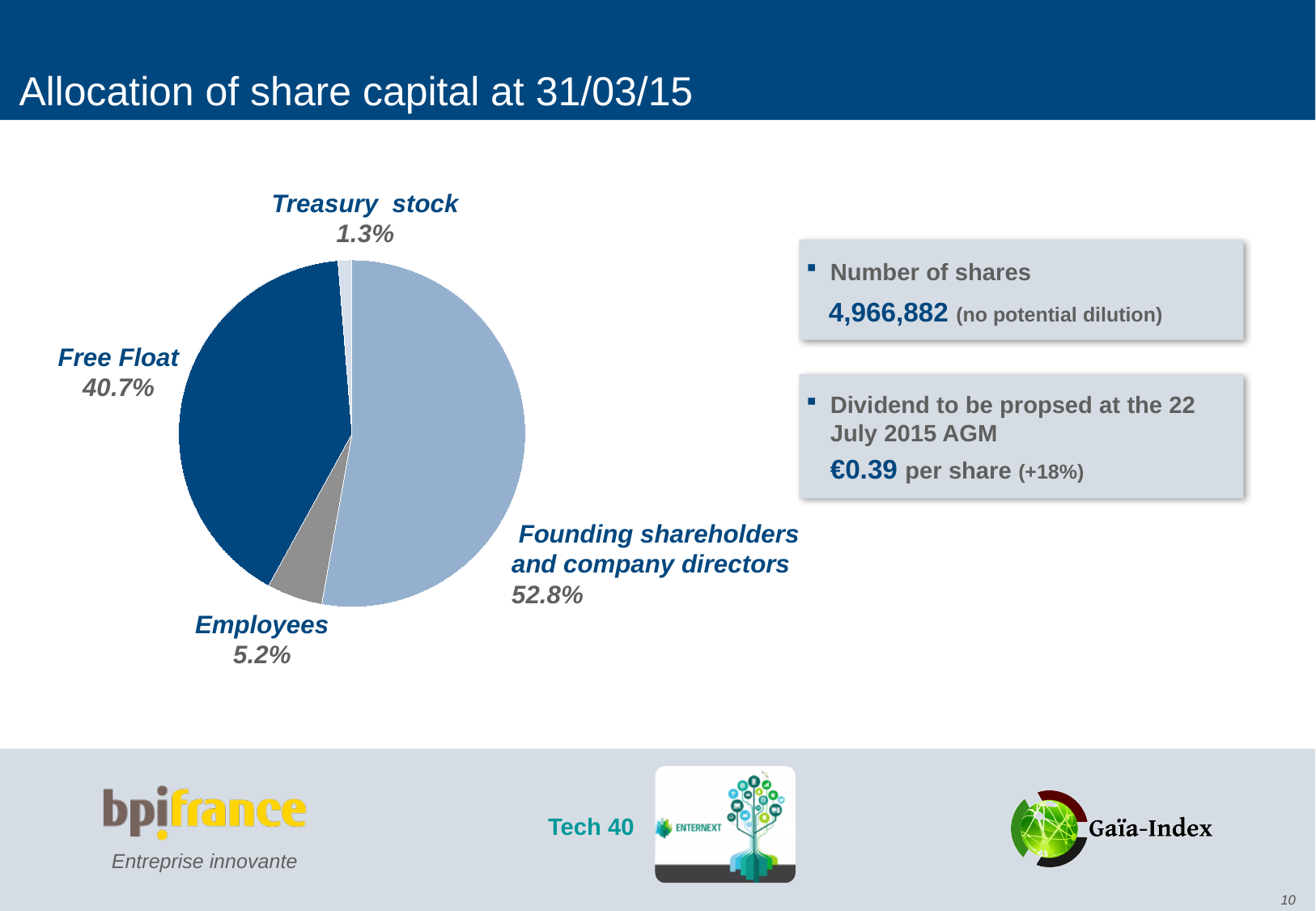
What kind of chart is shown on the slide? Pie chart Which category holds the smallest share of the capital? Treasury stock Which category holds the largest share of the capital? Founding shareholders and company directors How many categories does the pie chart show? 4 What share of the capital is held by employees? 5.2% Which is larger, the employees share or the treasury stock share? Employees What percentage of the share capital is treasury stock? 1.3% What is the combined share of employees and treasury stock? 6.5% What percentage of the share capital is free float? 40.7% What share of the share capital is held by founding shareholders and company directors? 52.8% What is the difference in percentage points between the founding shareholders and company directors share and the free float share? 12.1 percentage points What is the title of the slide containing the chart? Allocation of share capital at 31/03/15